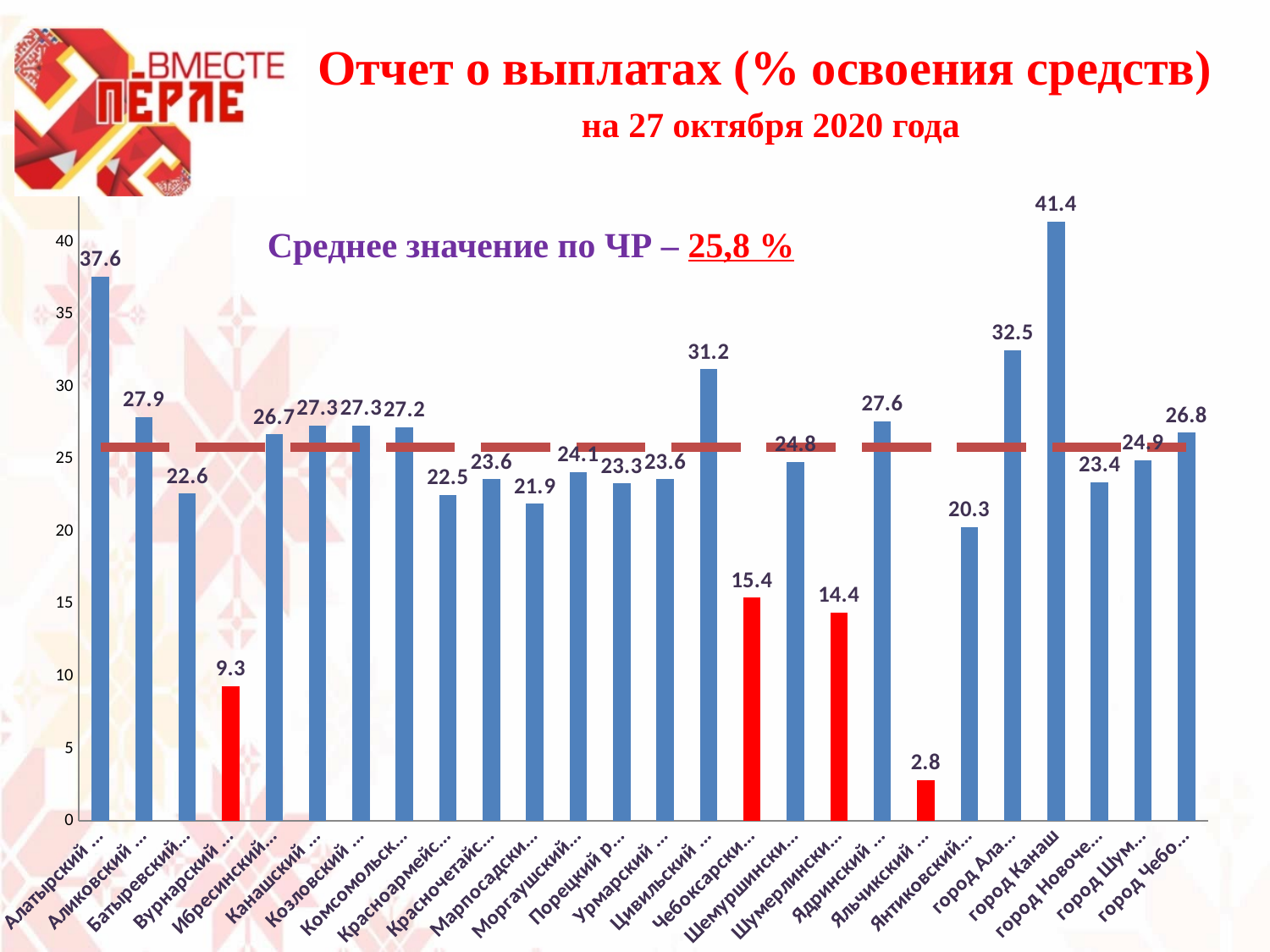
What average value for ЧР is stated on the slide? 25,8 % How many bars are coloured red? 4 Which is larger, the value for Вурнарский or the value for Чебоксарский? Чебоксарский How many bars are plotted in the chart? 26 What is the value for город Канаш? 41.4 What is the value for the Цивильский bar? 31.2 Which category has the highest value? город Канаш What is the difference between the values for город Канаш and Алатырский? 3.8 What kind of chart is shown on the slide? bar chart Which category has the lowest value? Яльчикский Is the value for Янтиковский greater or less than 25? less What is the value for the Яльчикский bar? 2.8